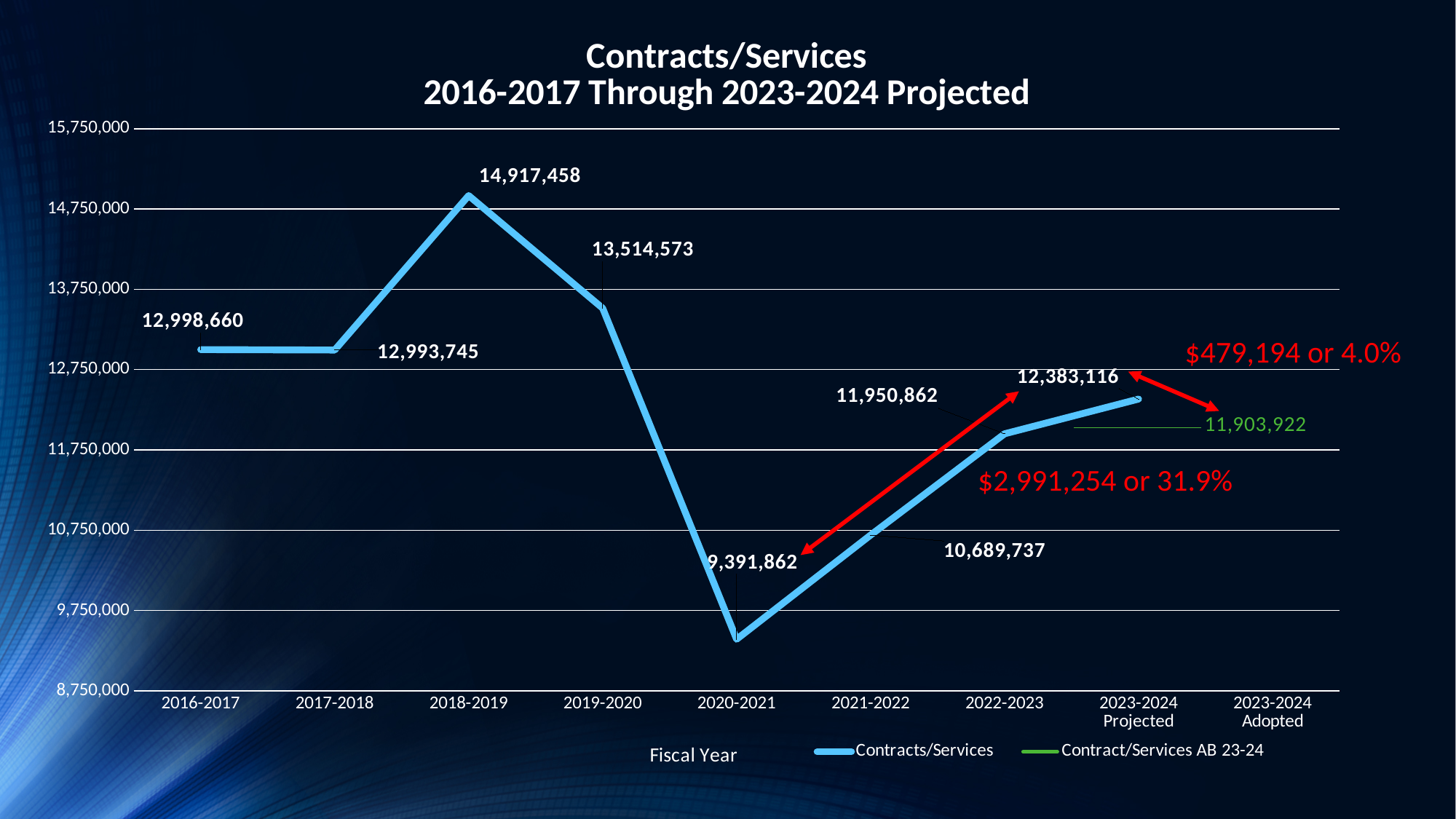
Does the Contracts/Services value rise or fall from 2020-2021 to 2023-2024 Projected? Rise Which fiscal year has the lowest Contracts/Services value? 2020-2021 What is the Contracts/Services value for 2018-2019? 14,917,458 What type of chart is shown on the slide? Line chart What is the Contracts/Services value for 2020-2021? 9,391,862 What is the difference between the 2018-2019 value and the 2019-2020 value? 1,402,885 What is the difference between the 2023-2024 Projected value and the 2023-2024 Adopted value? 479,194 What is the Contracts/Services value for 2023-2024 Projected? 12,383,116 What is the value shown for 2023-2024 Adopted? 11,903,922 Which fiscal year has the highest Contracts/Services value? 2018-2019 How many series does the legend list? 2 Which is larger, the value for 2021-2022 or the value for 2022-2023? 2022-2023